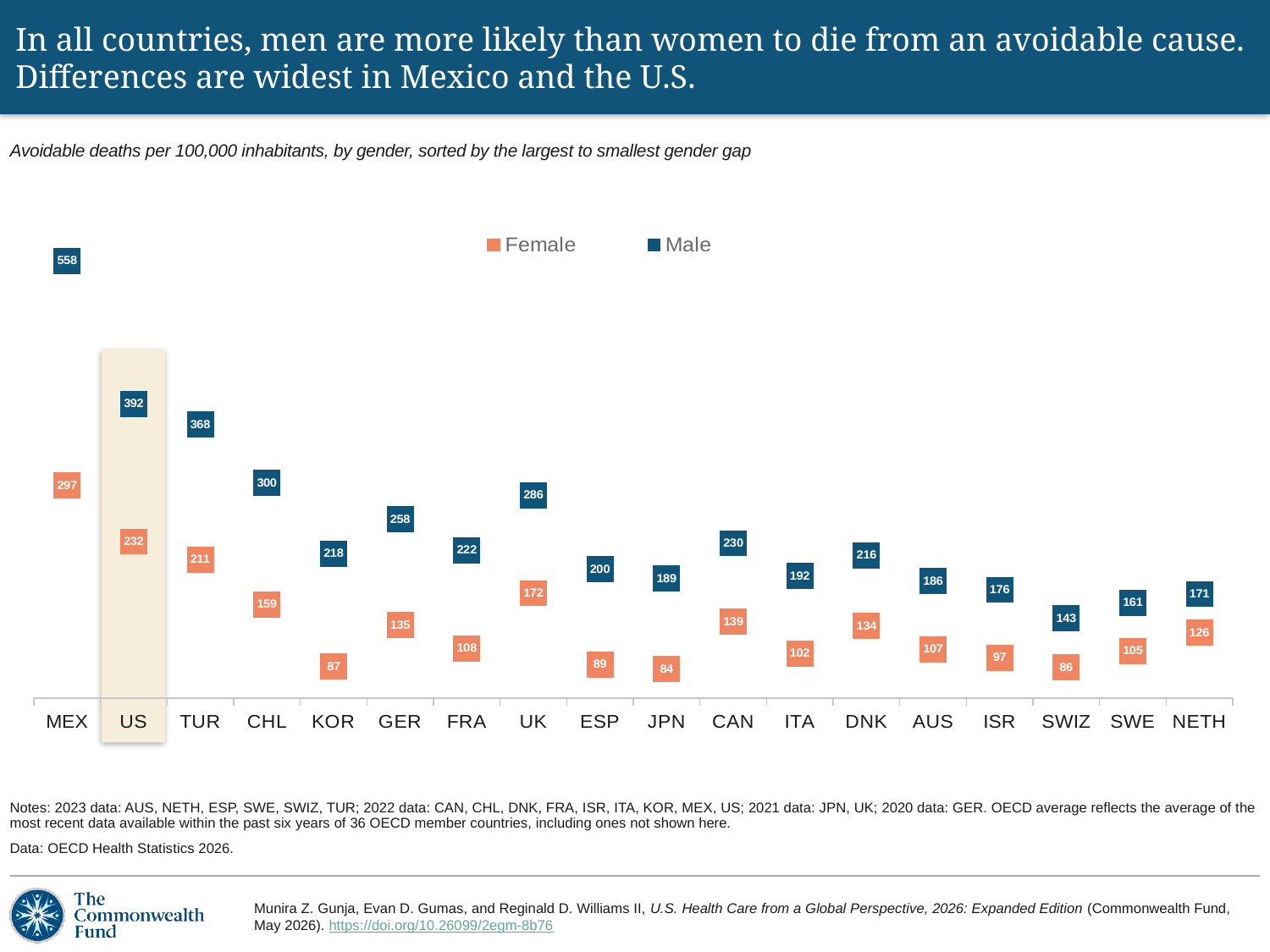
How many series does the legend list? 2 How many countries are shown on the x axis? 18 What is the Female value for JPN? 84 Which country has the highest Male value? MEX Which country has the lowest Female value? JPN What is the difference between the Male and Female values for MEX? 261 Which is larger, the Male value for TUR or the Male value for CHL? TUR What is the Female value for the US? 232 What is the Male value for MEX? 558 Which country is highlighted with a shaded background on the chart? US What is the Male value for the UK? 286 What is the difference between the Male and Female values for the US? 160